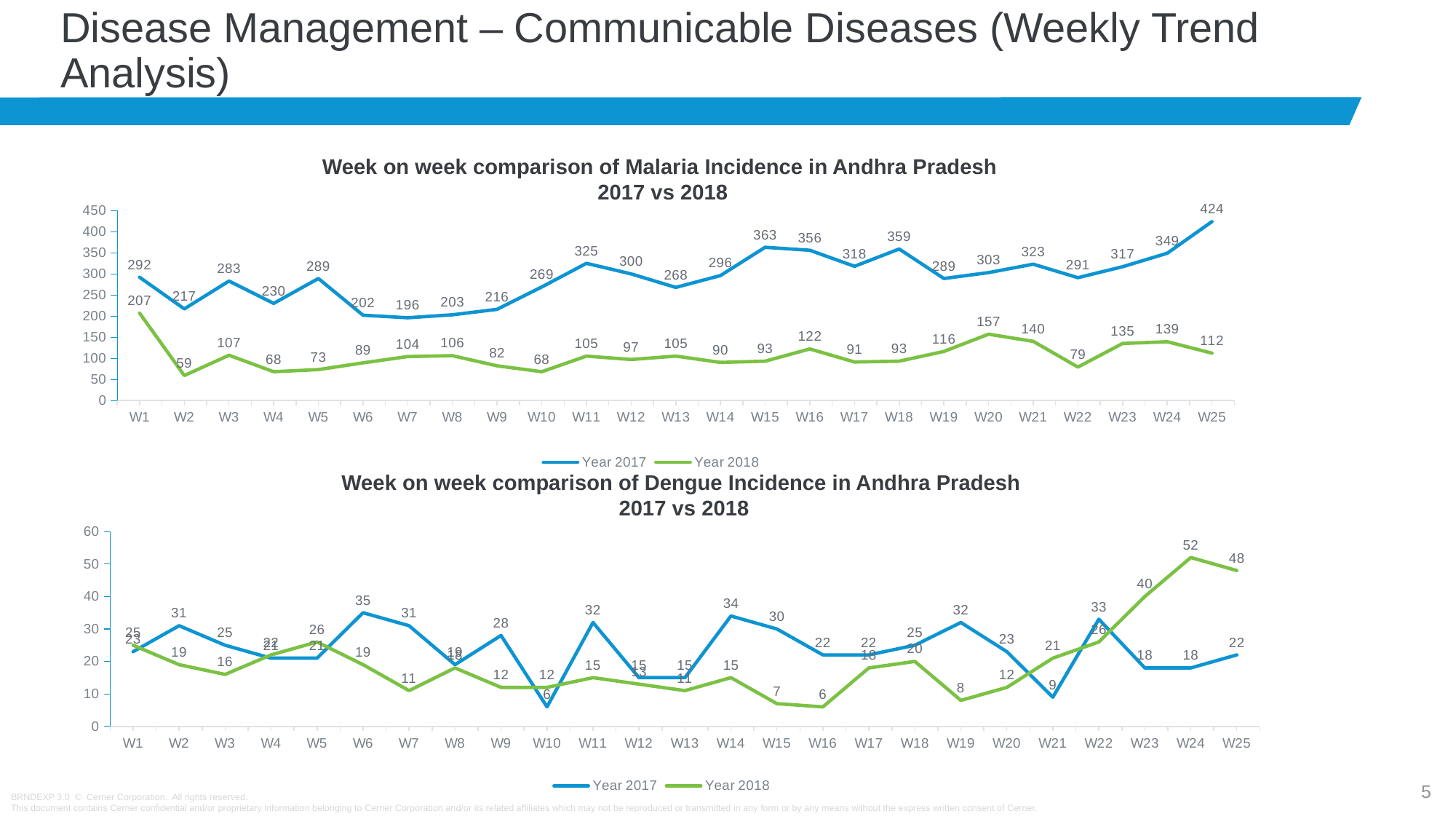
In the Dengue chart, which is larger in W21: the Year 2017 value or the Year 2018 value? Year 2018 In the Malaria chart, what is the difference between the Year 2017 and Year 2018 values in W1? 85 How many series does the legend of the Dengue chart list? 2 In the Dengue chart, which week has the highest Year 2017 value? W6 In the Malaria chart, what was the incidence in W25 for Year 2017? 424 What type of chart is the Malaria chart? Line chart In the Malaria chart, what was the incidence in W20 for Year 2018? 157 In the Malaria chart, which week has the highest Year 2017 value? W25 In the Malaria chart, how many weeks are shown on the x axis? 25 In the Malaria chart, which week has the lowest Year 2018 value? W2 In the Dengue chart, what was the incidence in W24 for Year 2018? 52 In the Dengue chart, what was the incidence in W10 for Year 2017? 6